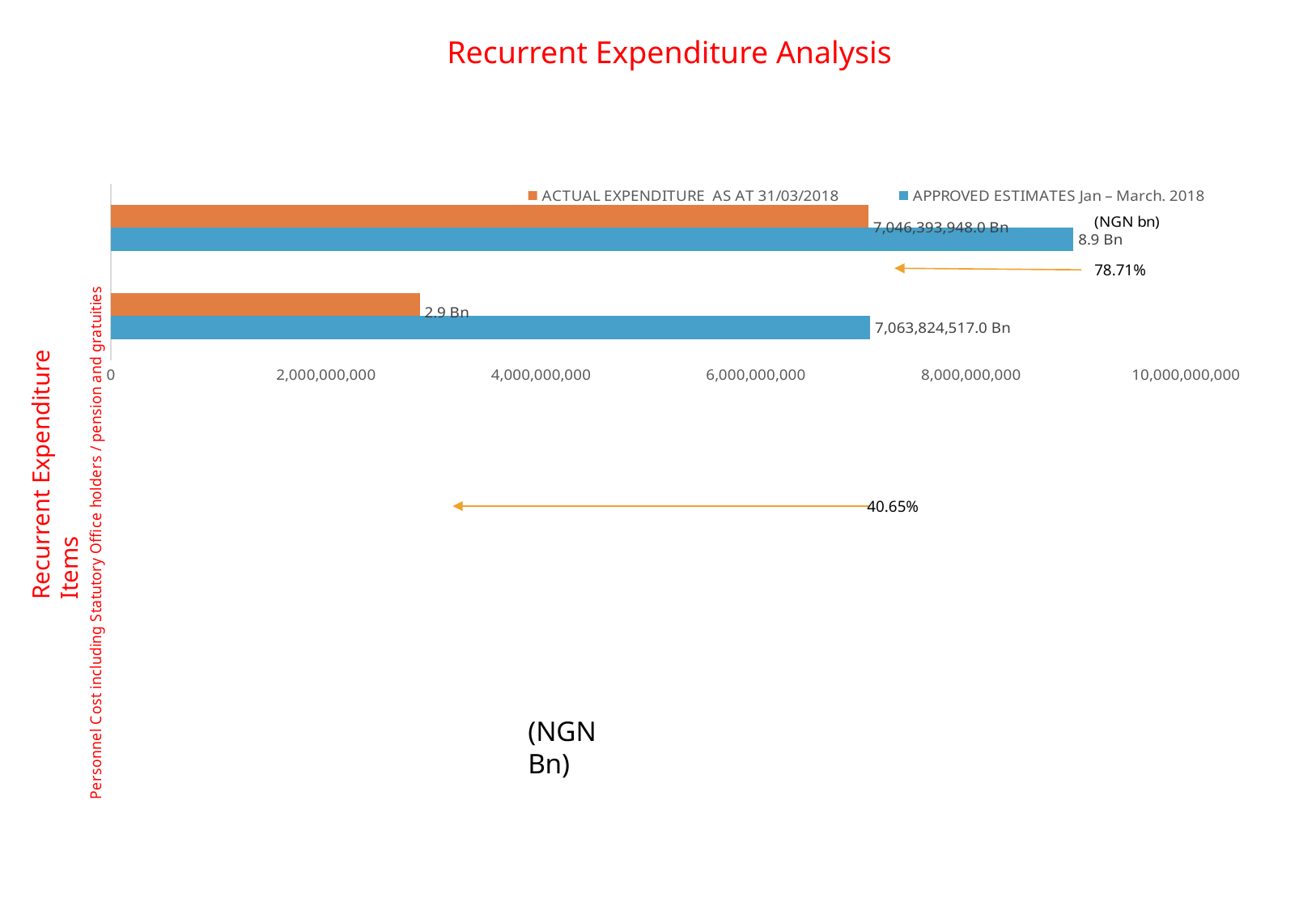
What is the data label on the ACTUAL EXPENDITURE AS AT 31/03/2018 bar in the bottom pair of bars? 2.9 Bn What is the data label on the APPROVED ESTIMATES Jan – March. 2018 bar in the bottom pair of bars? 7,063,824,517.0 Bn Is the ACTUAL EXPENDITURE AS AT 31/03/2018 bar in the bottom pair greater or less than 4,000,000,000? less Is the APPROVED ESTIMATES Jan – March. 2018 bar in the top pair greater or less than 8,000,000,000? greater How many pairs of bars (categories) are plotted on the chart? 2 What colour represents ACTUAL EXPENDITURE AS AT 31/03/2018 in the legend? orange What is the data label on the APPROVED ESTIMATES Jan – March. 2018 bar in the top pair of bars? 8.9 Bn In the top pair of bars, which series has the larger value, ACTUAL EXPENDITURE AS AT 31/03/2018 or APPROVED ESTIMATES Jan – March. 2018? APPROVED ESTIMATES Jan – March. 2018 In the bottom pair of bars, which series has the larger value, ACTUAL EXPENDITURE AS AT 31/03/2018 or APPROVED ESTIMATES Jan – March. 2018? APPROVED ESTIMATES Jan – March. 2018 What is the data label on the ACTUAL EXPENDITURE AS AT 31/03/2018 bar in the top pair of bars? 7,046,393,948.0 Bn What kind of chart is shown on the slide? bar chart How many series does the legend list? 2